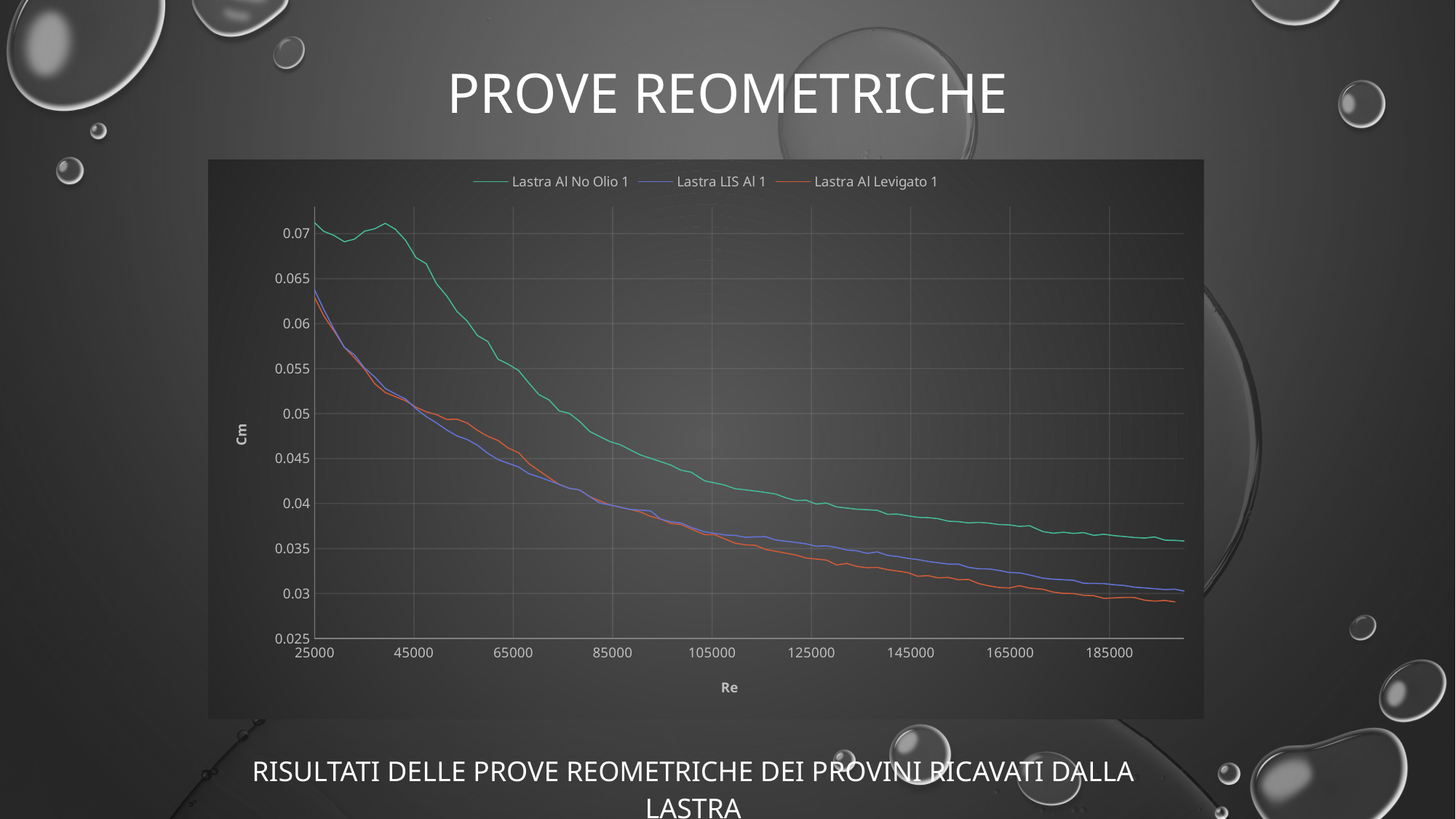
Which coloured line has the highest Cm values across the whole Re range? the green line What kind of chart is shown on the slide? line chart Is the value of the green line at Re = 185000 greater or less than 0.04? less What is the label on the vertical axis of the chart? Cm Which coloured line has the lowest Cm value at the right end of the chart (Re around 200000)? the orange line Is the value of the blue line at Re = 85000 greater or less than 0.045? less At Re = 65000, is the green line or the blue line higher? the green line Do the plotted values rise or fall as Re increases along the x axis? fall How many series does the legend list? 3 What are the three series names listed in the legend? Lastra Al No Olio 1, Lastra LIS Al 1, Lastra Al Levigato 1 Is the value of the green line at Re = 105000 greater or less than 0.04? greater